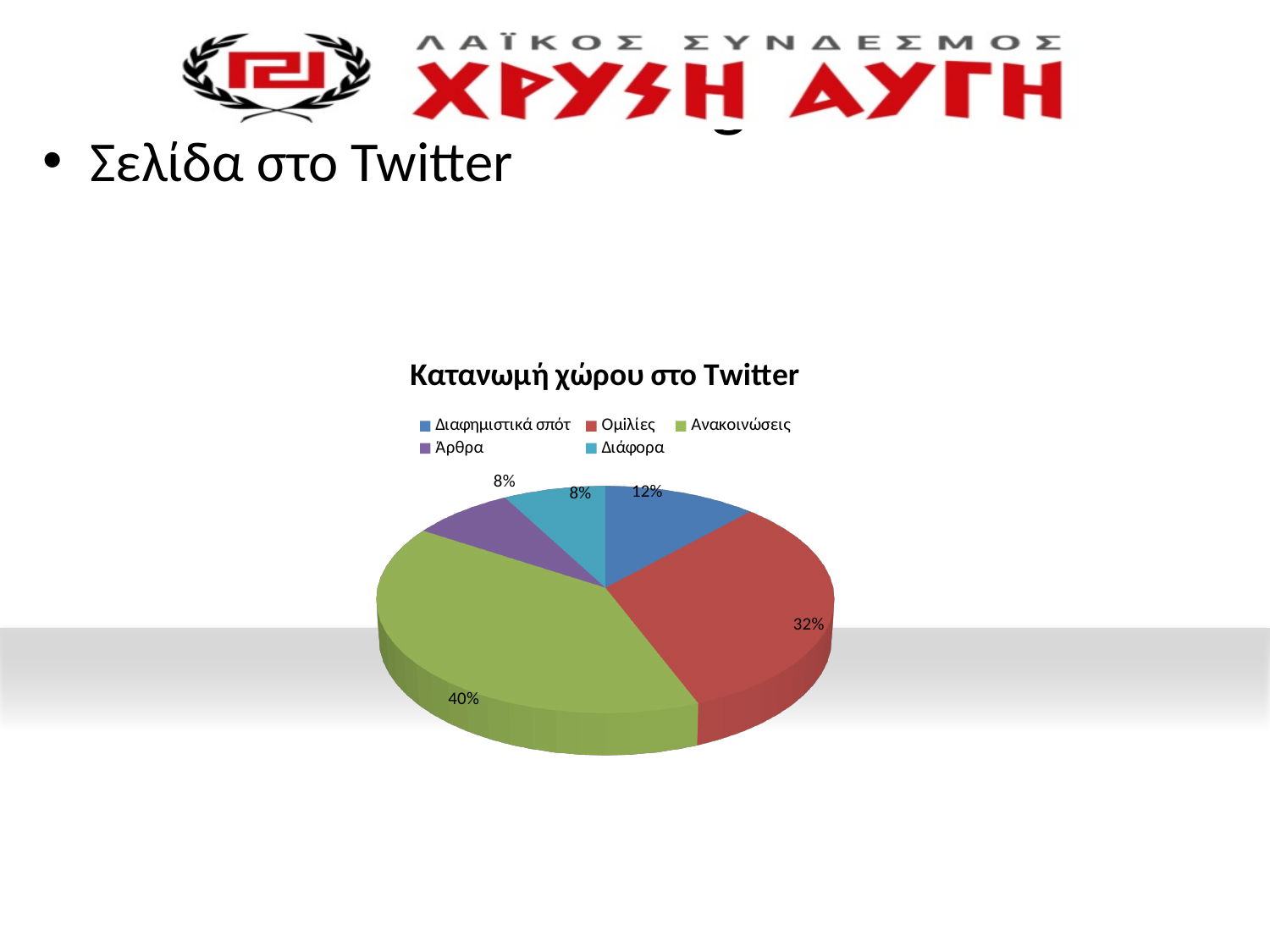
Which category has the largest slice of the pie? Ανακοινώσεις What share of the pie does Διαφημιστικά σποτ have? 12% What share of the pie does Ανακοινώσεις have? 40% What share of the pie does Άρθρα have? 8% What is the title of the chart? Κατανωμή χώρου στο Twitter What type of chart is shown on the slide? pie chart How many categories does the legend of the pie chart list? 5 Which colour represents Ανακοινώσεις in the pie chart? green What is the difference in percentage points between Ανακοινώσεις and Ομιλίες? 8 What is the combined share of Άρθρα and Διάφορα? 16% Which is larger, the share for Ομιλίες or the share for Διαφημιστικά σποτ? Ομιλίες